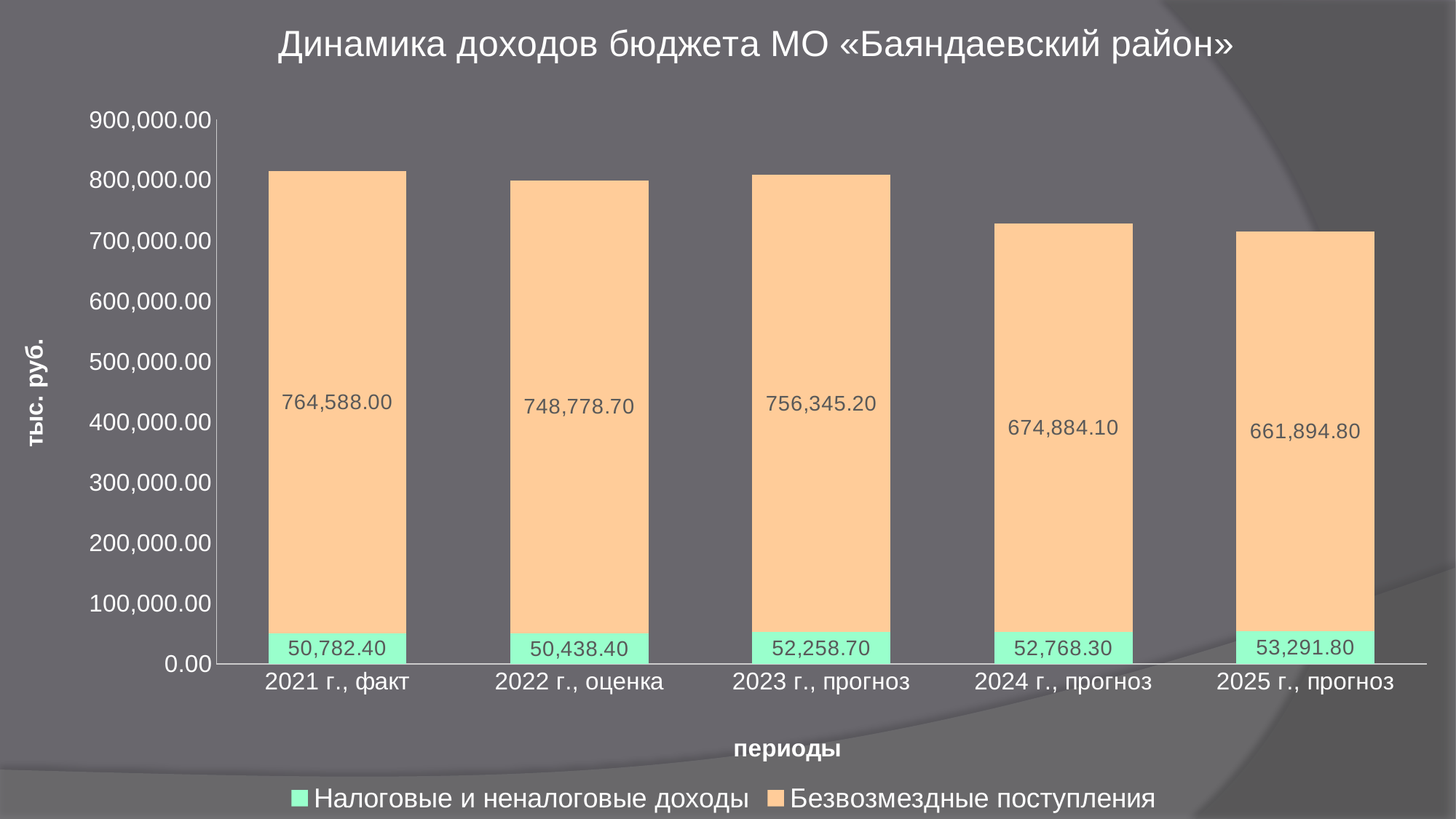
How many series does the legend list? 2 What is the total of the stacked bar for 2024 г., прогноз? 727,652.40 What is the difference between Безвозмездные поступления in 2021 г., факт and in 2025 г., прогноз? 102,693.20 How many periods are shown on the x axis? 5 What is the value of Безвозмездные поступления for 2021 г., факт? 764,588.00 In which period is Налоговые и неналоговые доходы the lowest? 2022 г., оценка What type of chart is shown on the slide? Stacked bar chart Which is larger: Налоговые и неналоговые доходы in 2024 г., прогноз or in 2025 г., прогноз? 2025 г., прогноз What is the title of the chart? Динамика доходов бюджета МО «Баяндаевский район» What is the value of Налоговые и неналоговые доходы for 2023 г., прогноз? 52,258.70 What is the value of Безвозмездные поступления for 2025 г., прогноз? 661,894.80 In which period is Безвозмездные поступления the highest? 2021 г., факт